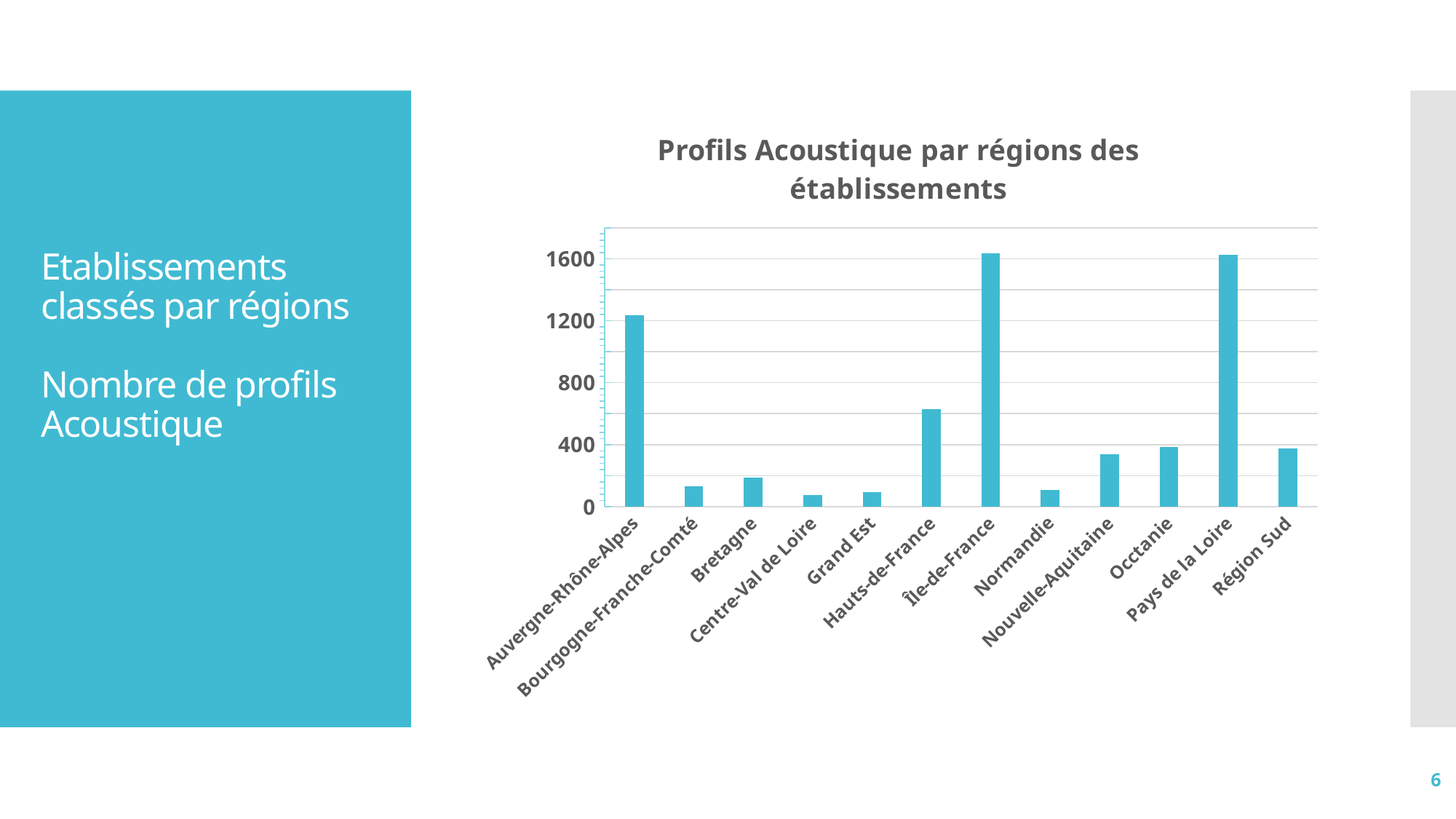
What kind of chart is shown on the slide? bar chart Which has a larger value, Auvergne-Rhône-Alpes or Hauts-de-France? Auvergne-Rhône-Alpes How many regions are shown on the x axis of the chart? 12 Is the value for Île-de-France greater or less than 1600? greater Is the value for Bretagne greater or less than 400? less What is the title of the chart? Profils Acoustique par régions des établissements Which has a larger value, Normandie or Nouvelle-Aquitaine? Nouvelle-Aquitaine Which has a larger value, Île-de-France or Occitanie? Île-de-France Is the value for Auvergne-Rhône-Alpes greater or less than 1200? greater